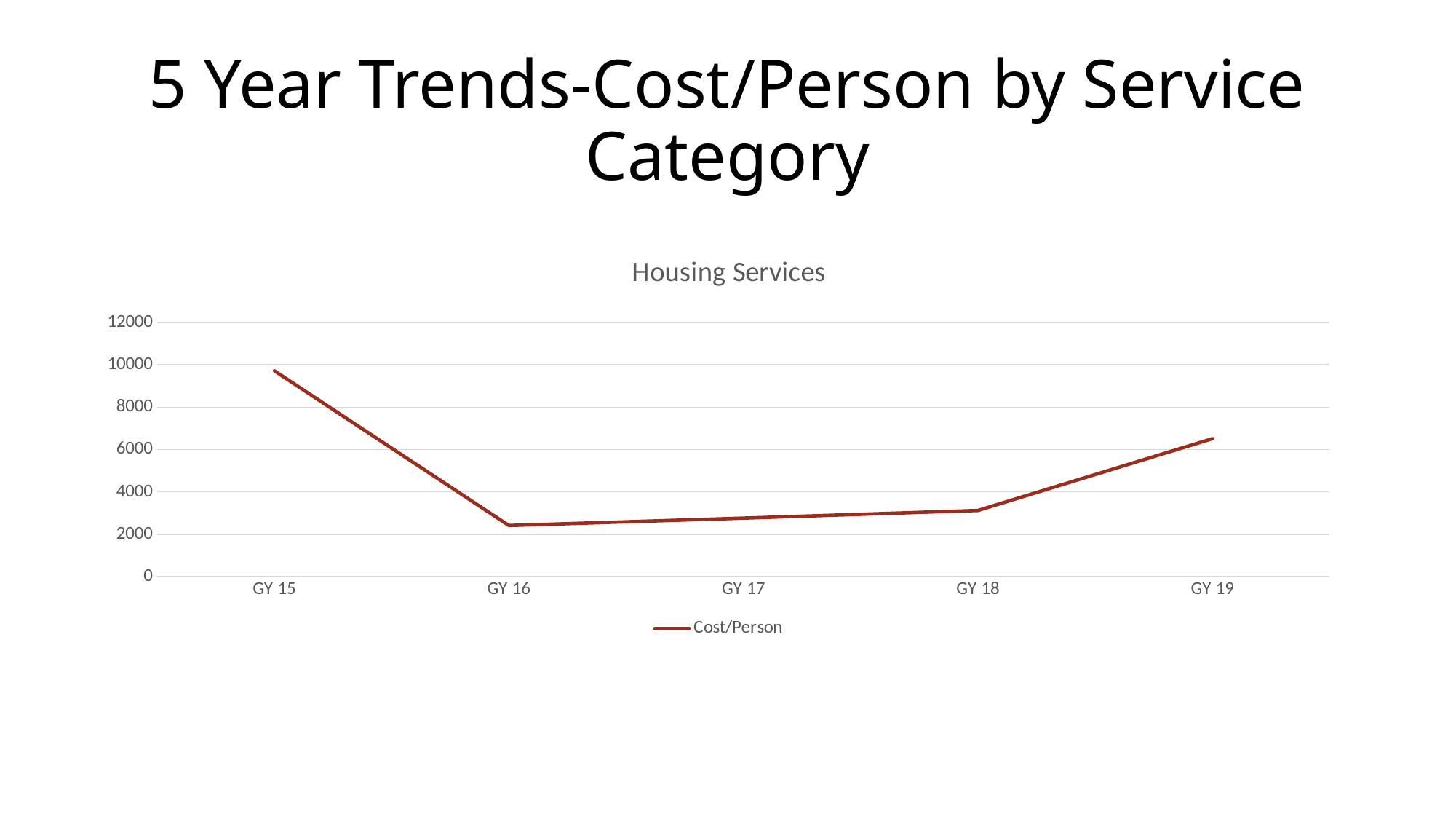
Is the Cost/Person for GY 19 greater or less than 6000? greater What is the title of the chart? Housing Services Which is larger, the Cost/Person for GY 15 or for GY 19? GY 15 Which year has the lowest Cost/Person? GY 16 Does the Cost/Person rise or fall from GY 15 to GY 16? fall What is the name of the series shown in the legend? Cost/Person What kind of chart is shown on the slide? line chart Is the Cost/Person for GY 16 greater or less than 4000? less Which year has the highest Cost/Person? GY 15 How many years are plotted along the x axis? 5 Is the Cost/Person for GY 15 greater or less than 8000? greater How many series does the legend list? 1